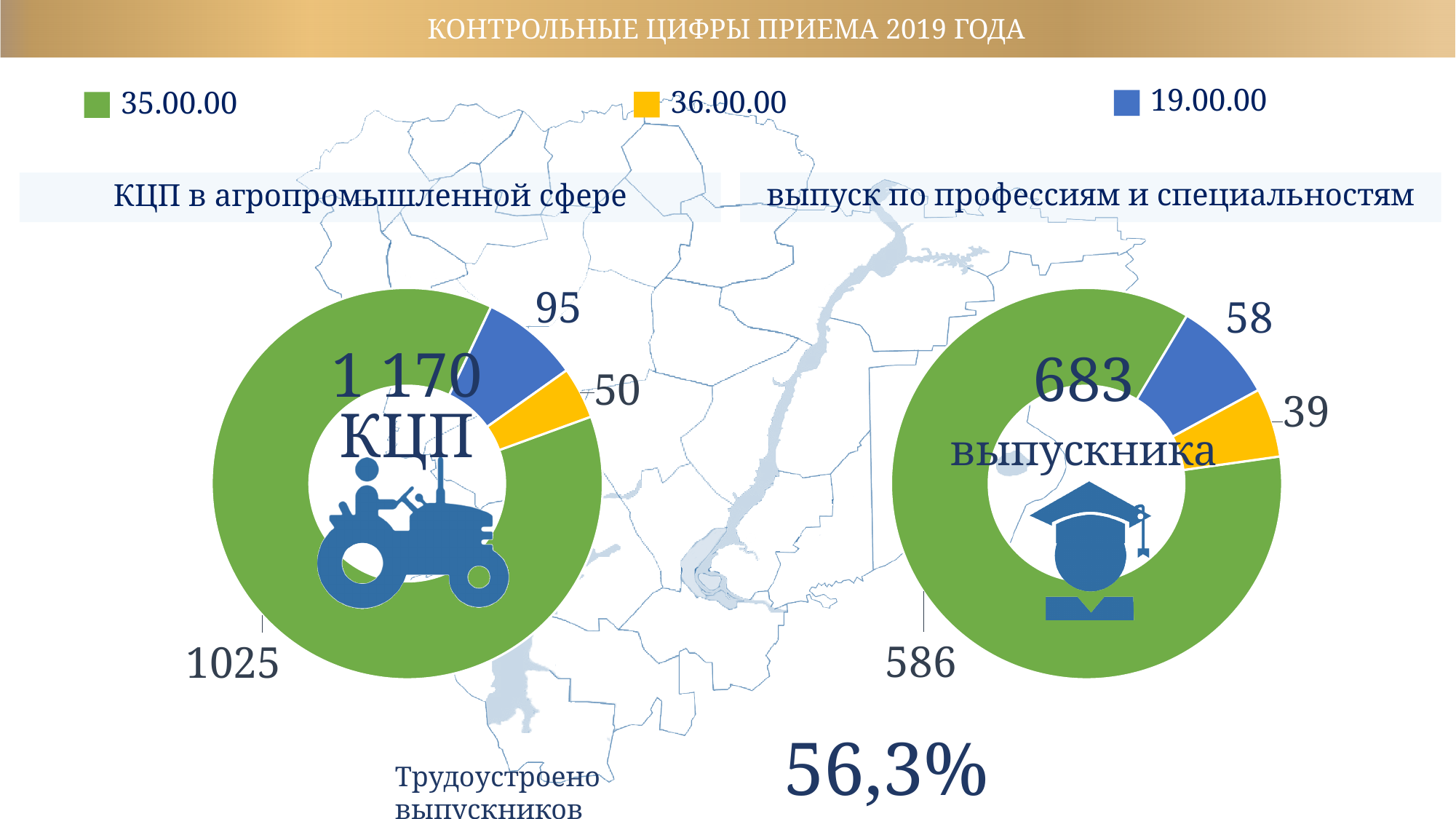
What kind of chart is used on the left for КЦП в агропромышленной сфере? Doughnut chart On the right chart (выпуск по профессиям и специальностям), what is the value for 36.00.00? 39 On the left chart (КЦП в агропромышленной сфере), what is the value for 35.00.00? 1025 On the left chart (КЦП в агропромышленной сфере), what is the value for 19.00.00? 95 On the right chart (выпуск по профессиям и специальностям), which category has the lowest value? 36.00.00 On the left chart (КЦП в агропромышленной сфере), what is the difference between the values for 19.00.00 and 36.00.00? 45 On the left chart (КЦП в агропромышленной сфере), what is the value for 36.00.00? 50 On the right chart (выпуск по профессиям и специальностям), what is the value for 35.00.00? 586 What total is printed in the centre of the right chart (выпуск по профессиям и специальностям)? 683 On the right chart (выпуск по профессиям и специальностям), which is larger: the value for 19.00.00 or the value for 36.00.00? 19.00.00 How many categories does the legend at the top of the slide list? 3 On the left chart (КЦП в агропромышленной сфере), which category has the highest value? 35.00.00